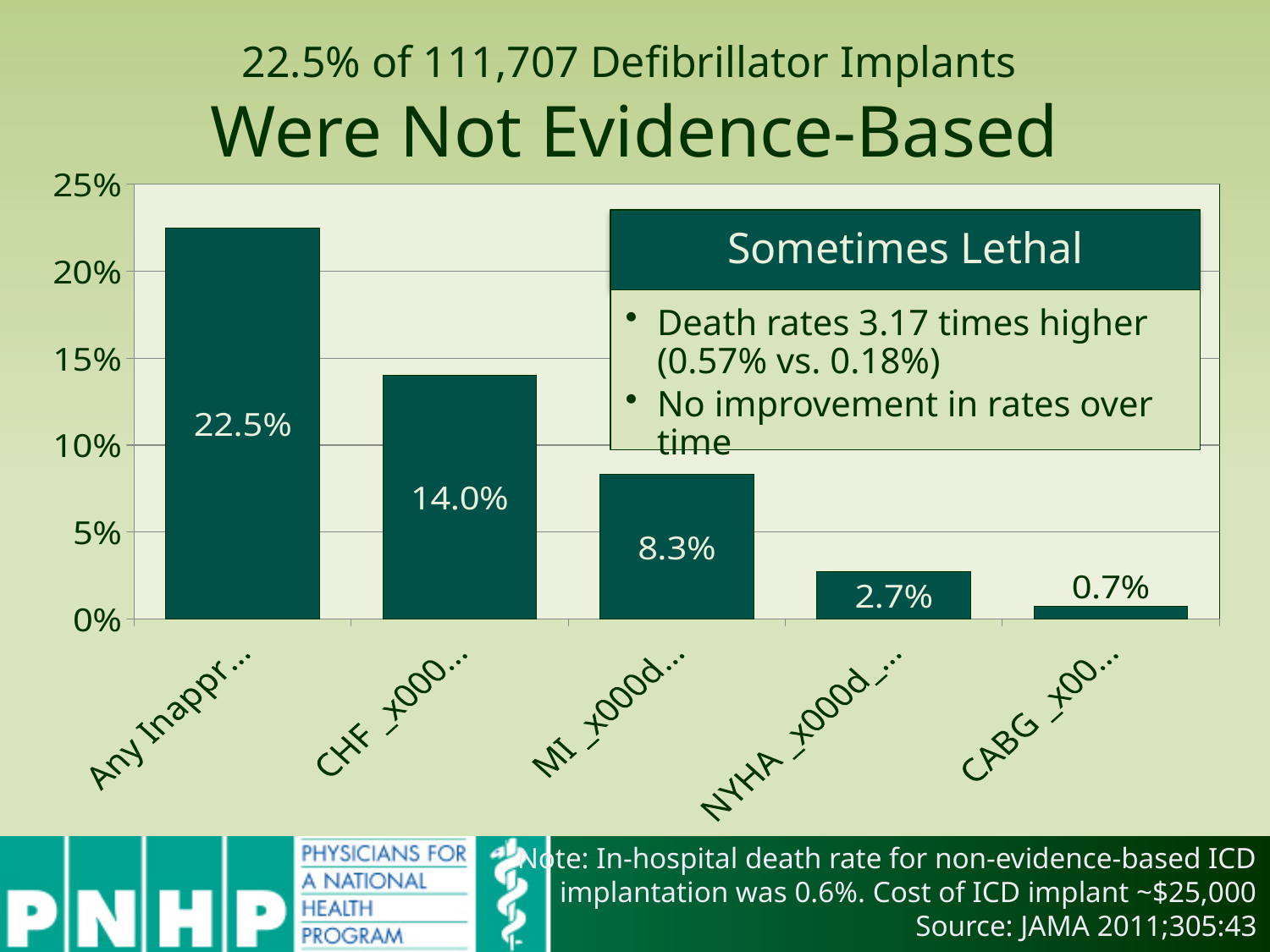
What is the value of the CABG bar? 0.7% What is the difference between the CHF bar and the MI bar? 5.7% Which bar has the highest value? Any Inappr... What kind of chart is shown on the slide? bar chart What is the value of the first bar, labelled 'Any Inappr...'? 22.5% What is the value of the CHF bar? 14.0% What is the value of the NYHA bar? 2.7% What is the value of the MI bar? 8.3% Is the value for the MI bar greater or less than 10%? less Which bar has the lowest value? CABG Which is larger, the NYHA bar or the CABG bar? NYHA How many bars are plotted in the chart? 5